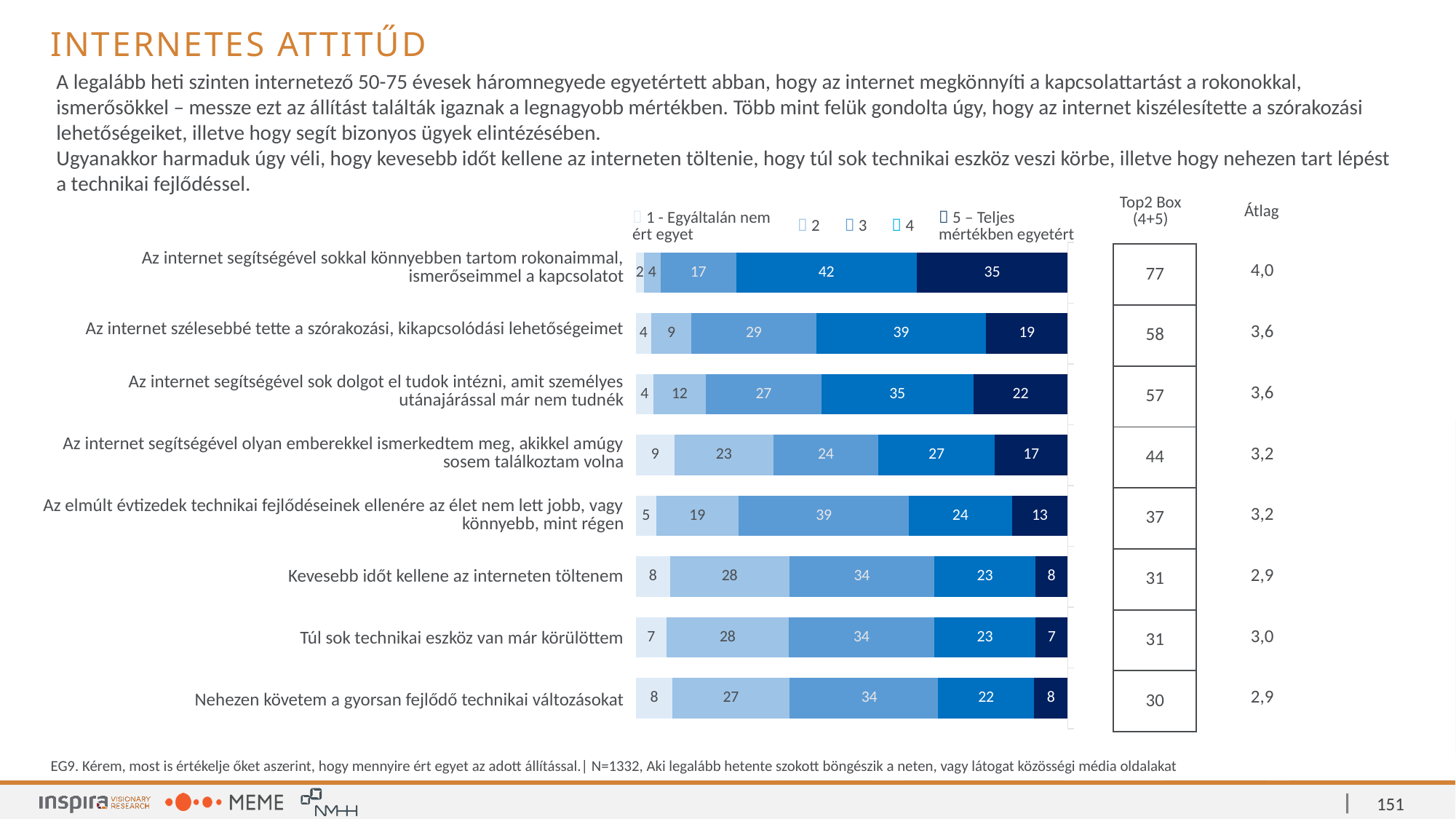
What is the total of all segments in the bar for 'Túl sok technikai eszköz van már körülöttem'? 99 Which has a larger '4' segment: 'Az internet szélesebbé tette a szórakozási, kikapcsolódási lehetőségeimet' or 'Az internet segítségével sok dolgot el tudok intézni, amit személyes utánajárással már nem tudnék'? Az internet szélesebbé tette a szórakozási, kikapcsolódási lehetőségeimet How many series does the chart legend list? 5 How many statements (categories) are plotted in the chart? 8 What is the value of the '2' segment for 'Az internet segítségével olyan emberekkel ismerkedtem meg, akikkel amúgy sosem találkoztam volna'? 23 What is the value of the '3' segment for 'Kevesebb időt kellene az interneten töltenem'? 34 For 'Az internet segítségével sokkal könnyebben tartom rokonaimmal, ismerőseimmel a kapcsolatot', what is the difference between the '4' segment and the '5 – Teljes mértékben egyetért' segment? 7 What is the label of the first legend entry in the chart? 1 - Egyáltalán nem ért egyet What is the value of the '5 – Teljes mértékben egyetért' segment for 'Az internet segítségével sokkal könnyebben tartom rokonaimmal, ismerőseimmel a kapcsolatot'? 35 What kind of chart is shown on the slide? Stacked bar chart Which statement has the lowest value for the '1 - Egyáltalán nem ért egyet' segment? Az internet segítségével sokkal könnyebben tartom rokonaimmal, ismerőseimmel a kapcsolatot Which statement has the highest value for the '5 – Teljes mértékben egyetért' segment? Az internet segítségével sokkal könnyebben tartom rokonaimmal, ismerőseimmel a kapcsolatot